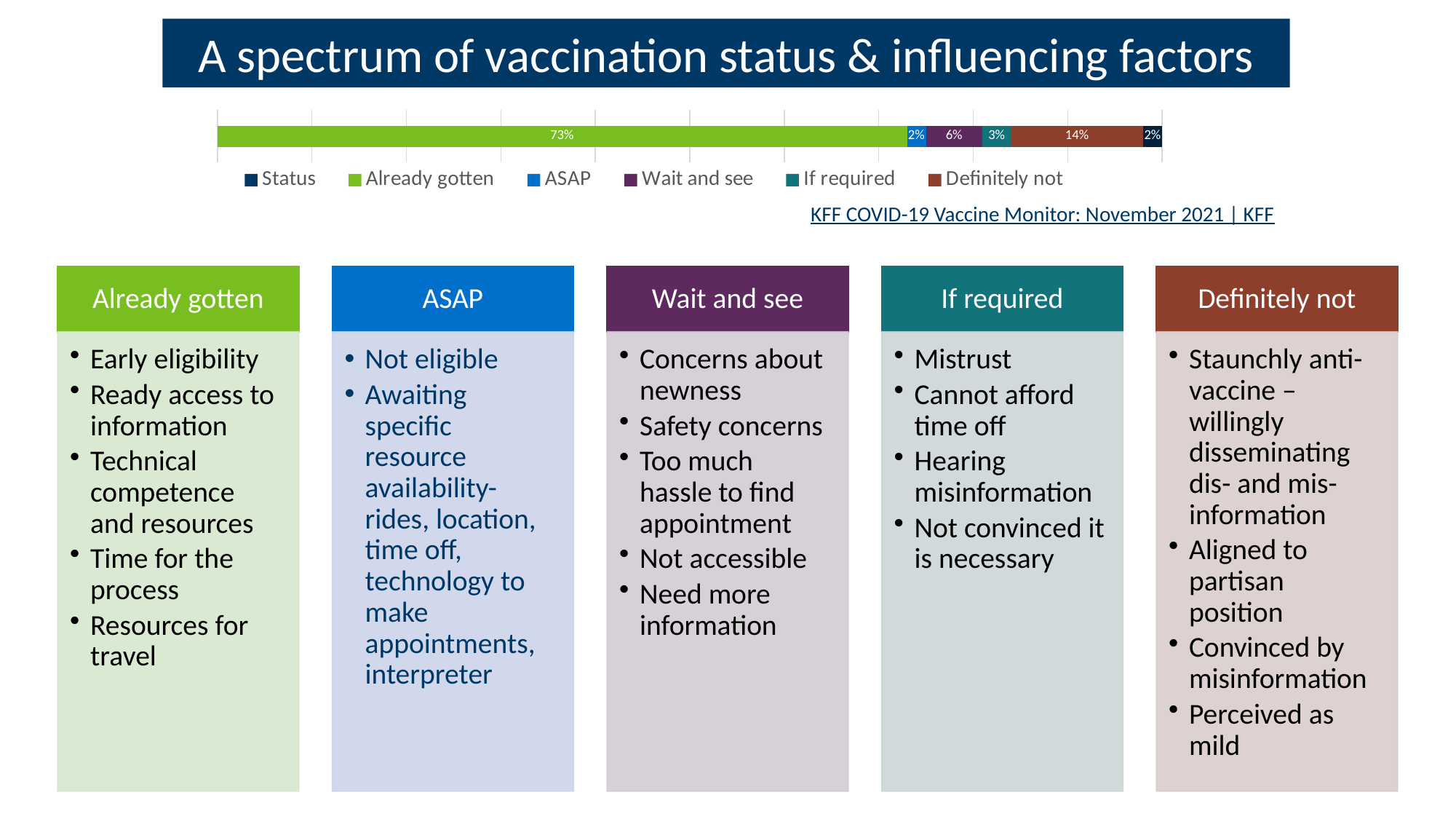
Which segment of the stacked bar has the largest value? Already gotten Which is larger, the Wait and see segment or the If required segment? Wait and see What percentage does the chart show for the If required segment? 3% What kind of chart is shown on the slide? Stacked bar chart What colour is the Already gotten segment in the chart? Green How many series does the chart legend list? 6 What is the difference between the Definitely not value and the Wait and see value? 8% What percentage does the chart show for the ASAP segment? 2% What is the difference between the Already gotten value and the Definitely not value? 59% What percentage does the chart show for the Definitely not segment? 14% What percentage does the chart show for the Already gotten segment? 73% What percentage does the chart show for the Wait and see segment? 6%